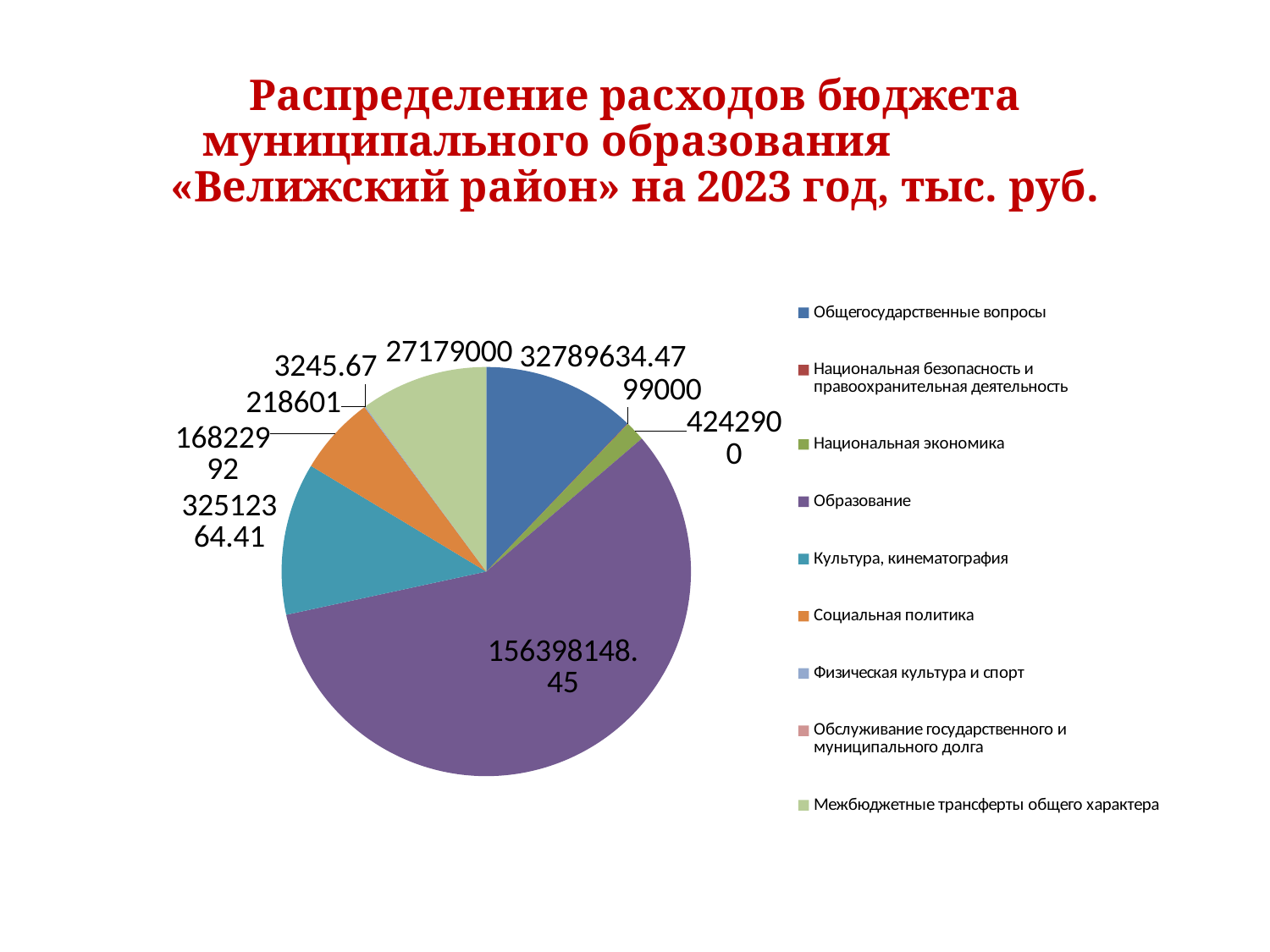
Which is larger, the value for Общегосударственные вопросы or the value for Межбюджетные трансферты общего характера? Общегосударственные вопросы What is the value shown for Физическая культура и спорт? 218601 What is the value shown for Образование? 156398148.45 Which category has the largest slice of the pie chart? Образование Which is larger, the value for Образование or the value for Культура, кинематография? Образование What kind of chart is shown on the slide? pie chart What is the value shown for Общегосударственные вопросы? 32789634.47 What is the value shown for Межбюджетные трансферты общего характера? 27179000 How many categories does the legend of the pie chart list? 9 What is the value shown for Обслуживание государственного и муниципального долга? 3245.67 What is the value shown for Национальная безопасность и правоохранительная деятельность? 99000 What year does the chart title say the budget expenditure distribution is for? 2023